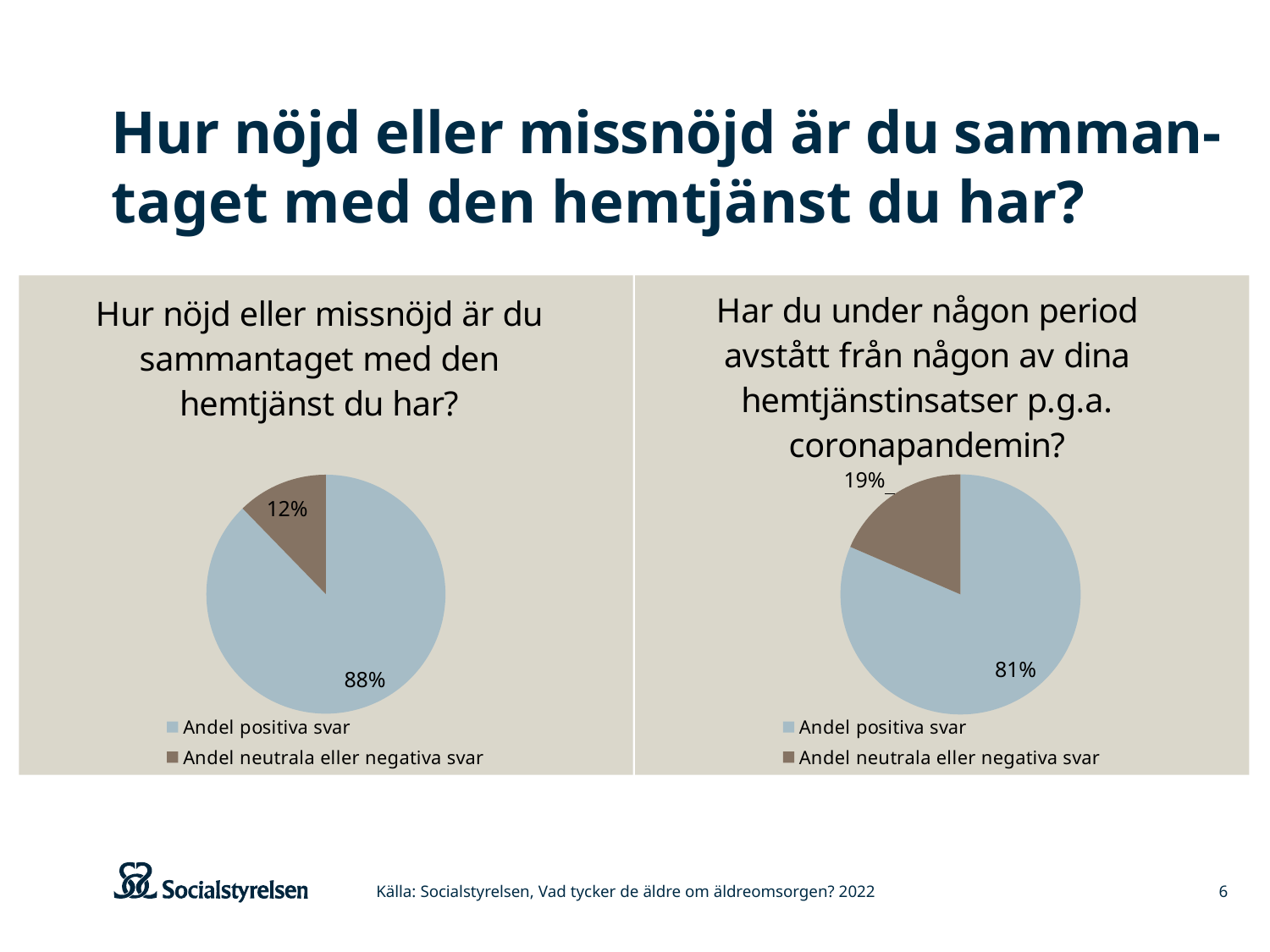
How many slices does the right chart have? 2 In the right chart (Har du under någon period avstått från någon av dina hemtjänstinsatser p.g.a. coronapandemin?), what is the value for Andel positiva svar? 81% In the right chart, which slice is the smallest? Andel neutrala eller negativa svar In the left chart (Hur nöjd eller missnöjd är du sammantaget med den hemtjänst du har?), what is the value for Andel positiva svar? 88% In the left chart, what is the difference between Andel positiva svar and Andel neutrala eller negativa svar? 76 percentage points In the left chart, which slice is the largest? Andel positiva svar How many entries does the legend of the left chart list? 2 In the right chart (Har du under någon period avstått från någon av dina hemtjänstinsatser p.g.a. coronapandemin?), what is the value for Andel neutrala eller negativa svar? 19% In the left chart (Hur nöjd eller missnöjd är du sammantaget med den hemtjänst du har?), what is the value for Andel neutrala eller negativa svar? 12% Which chart has the larger value for Andel neutrala eller negativa svar, the left chart or the right chart? The right chart In the right chart, what is the difference between Andel positiva svar and Andel neutrala eller negativa svar? 62 percentage points What kind of chart is the left chart? Pie chart